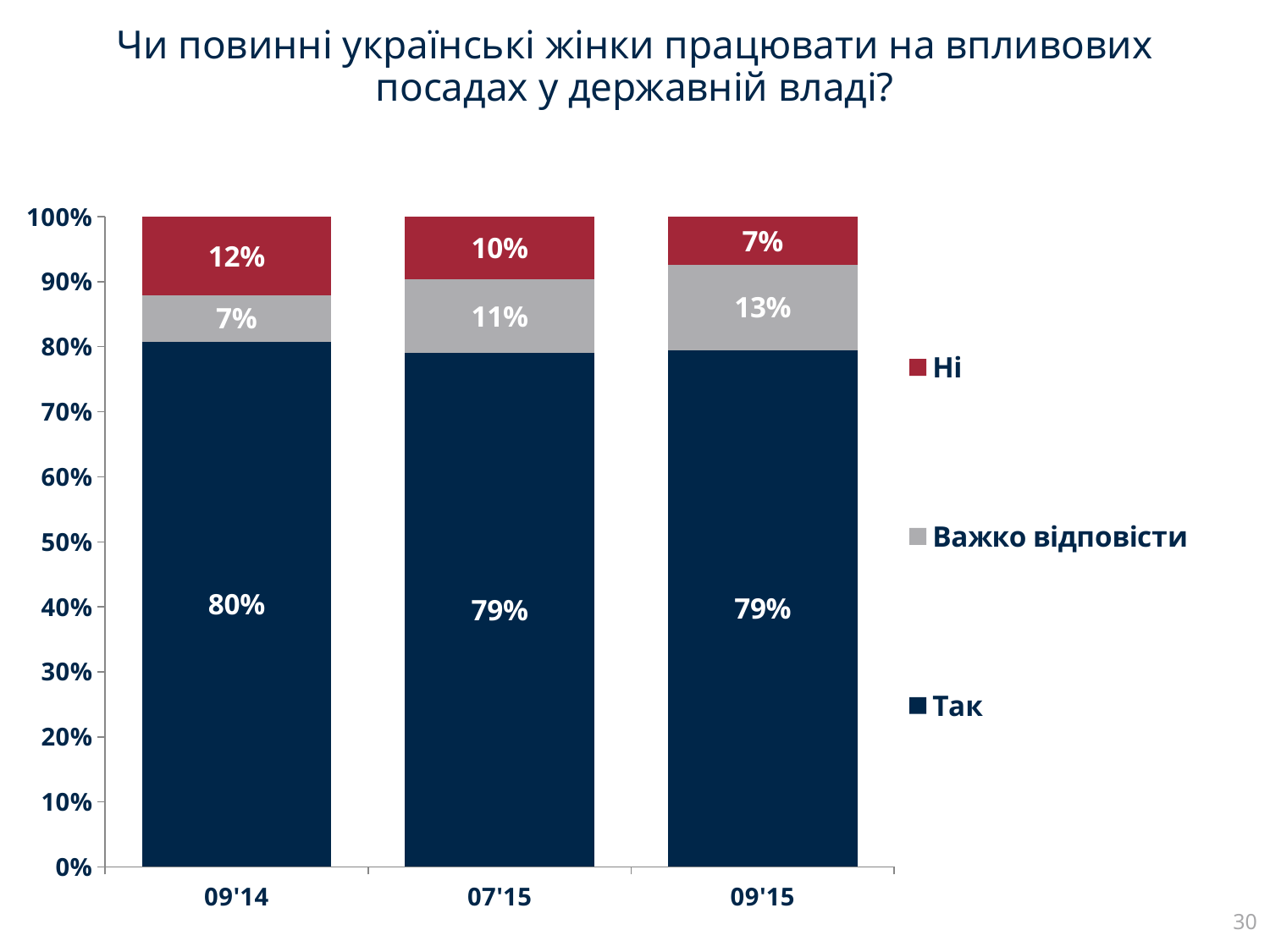
In which period is the "Ні" value highest? 09'14 What is the value for "Важко відповісти" in 07'15? 11% In which period is the "Важко відповісти" value lowest? 09'14 Which series is shown in red? Ні What is the difference between the "Ні" values in 09'14 and 09'15? 5% What kind of chart is shown on the slide? Stacked bar chart Does the "Ні" value rise or fall from 09'14 to 09'15? Fall Which is larger in 07'15: the "Ні" value or the "Важко відповісти" value? Важко відповісти What is the value for "Ні" in 09'15? 7% How many periods are shown on the x axis? 3 How many series does the legend list? 3 What is the value for "Так" in 09'14? 80%